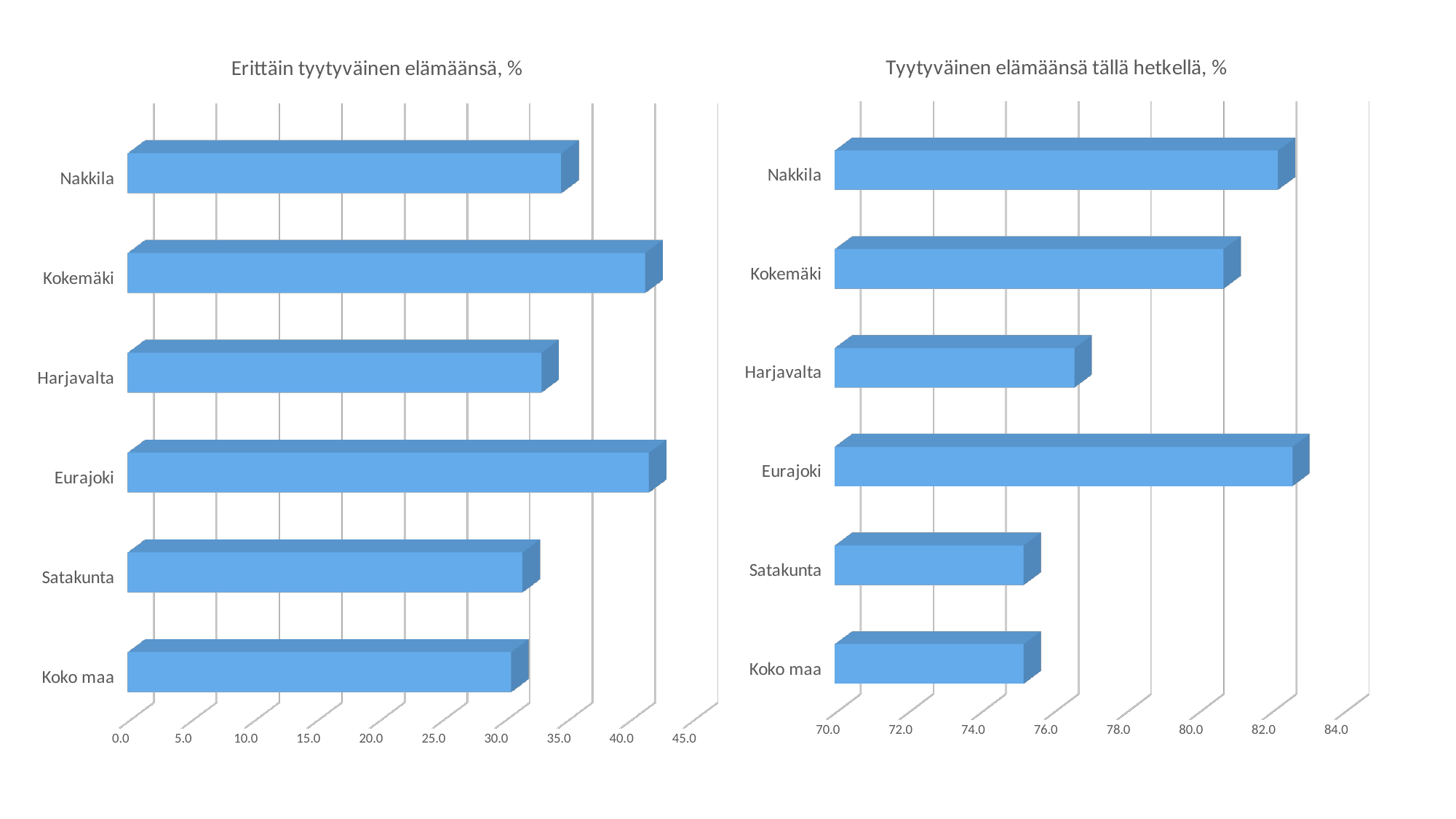
How many categories are shown in the left chart, 'Erittäin tyytyväinen elämäänsä, %'? 6 In the left chart, 'Erittäin tyytyväinen elämäänsä, %', is the value for Satakunta greater or less than 35.0? less In the right chart, 'Tyytyväinen elämäänsä tällä hetkellä, %', which is larger, the value for Kokemäki or the value for Harjavalta? Kokemäki In the left chart, 'Erittäin tyytyväinen elämäänsä, %', is the value for Kokemäki greater or less than 40.0? greater In the left chart, 'Erittäin tyytyväinen elämäänsä, %', is the value for Nakkila greater or less than 30.0? greater How many categories are shown in the right chart, 'Tyytyväinen elämäänsä tällä hetkellä, %'? 6 In the left chart, 'Erittäin tyytyväinen elämäänsä, %', which is larger, the value for Nakkila or the value for Koko maa? Nakkila What is the title of the right chart? Tyytyväinen elämäänsä tällä hetkellä, % What kind of chart is the left chart, 'Erittäin tyytyväinen elämäänsä, %'? Bar chart